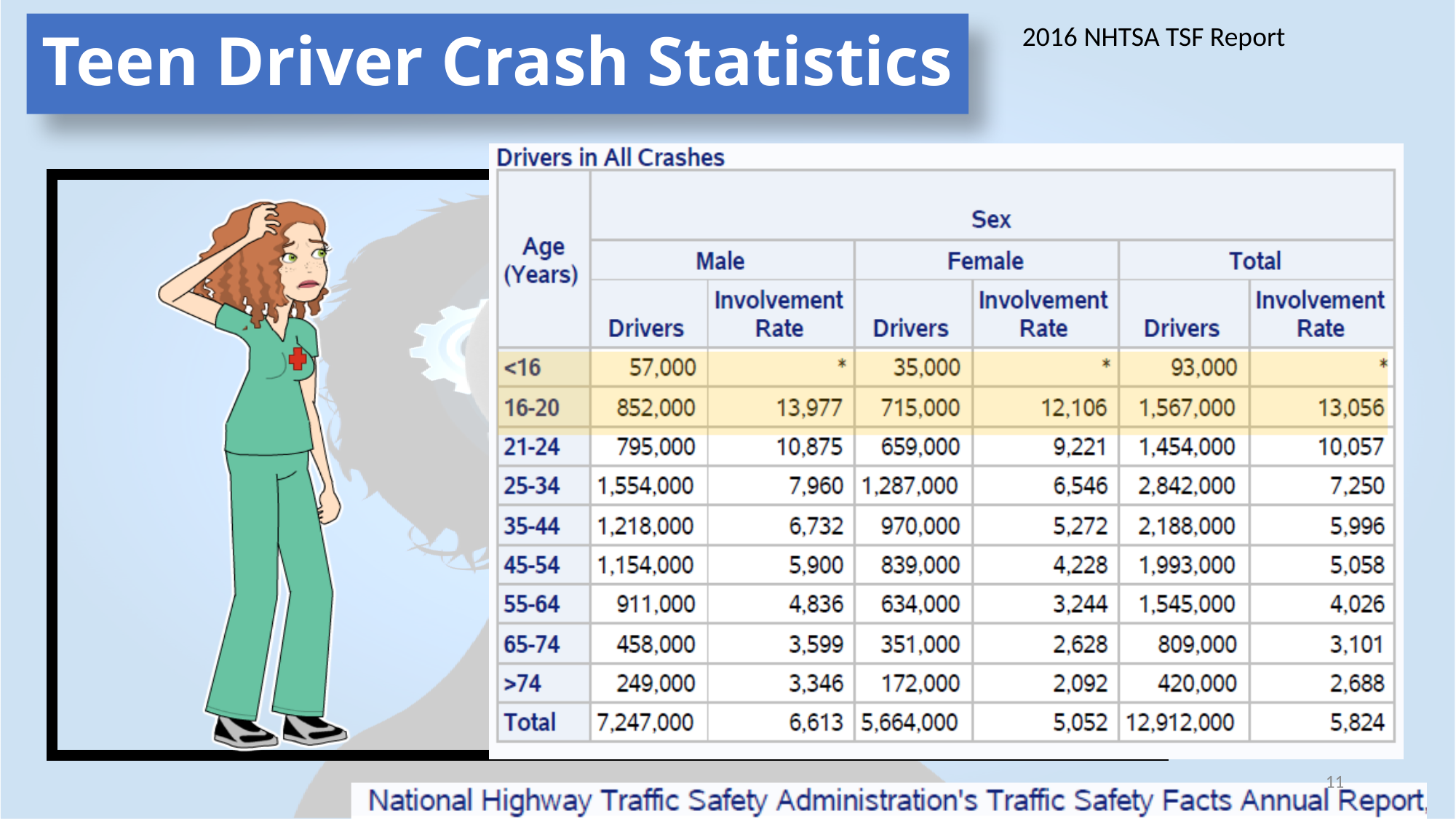
What is the title of the table shown on the slide? Drivers in All Crashes In the Drivers in All Crashes table, how much higher is the Male Involvement Rate than the Female Involvement Rate for the 16-20 age group? 1,871 In the Drivers in All Crashes table, what is the Total Involvement Rate for the 16-20 age group? 13,056 In the Drivers in All Crashes table, what is the difference in Total Drivers between the 16-20 and 21-24 age groups? 113,000 In the Drivers in All Crashes table, which age group has the largest number of Total Drivers? 25-34 In the Drivers in All Crashes table, what is the Female Involvement Rate for the 65-74 age group? 2,628 How many age groups (excluding the Total row) are listed in the Drivers in All Crashes table? 9 In the Drivers in All Crashes table, which age group has the highest Total Involvement Rate among the groups with a rate shown? 16-20 In the Drivers in All Crashes table, how many Male Drivers are listed for the 25-34 age group? 1,554,000 In the Drivers in All Crashes table, which age group has the fewest Total Drivers? <16 In the Drivers in All Crashes table, what is the overall Total number of Drivers across all ages? 12,912,000 In the Drivers in All Crashes table, are there more Male Drivers or Female Drivers in the 21-24 age group? Male